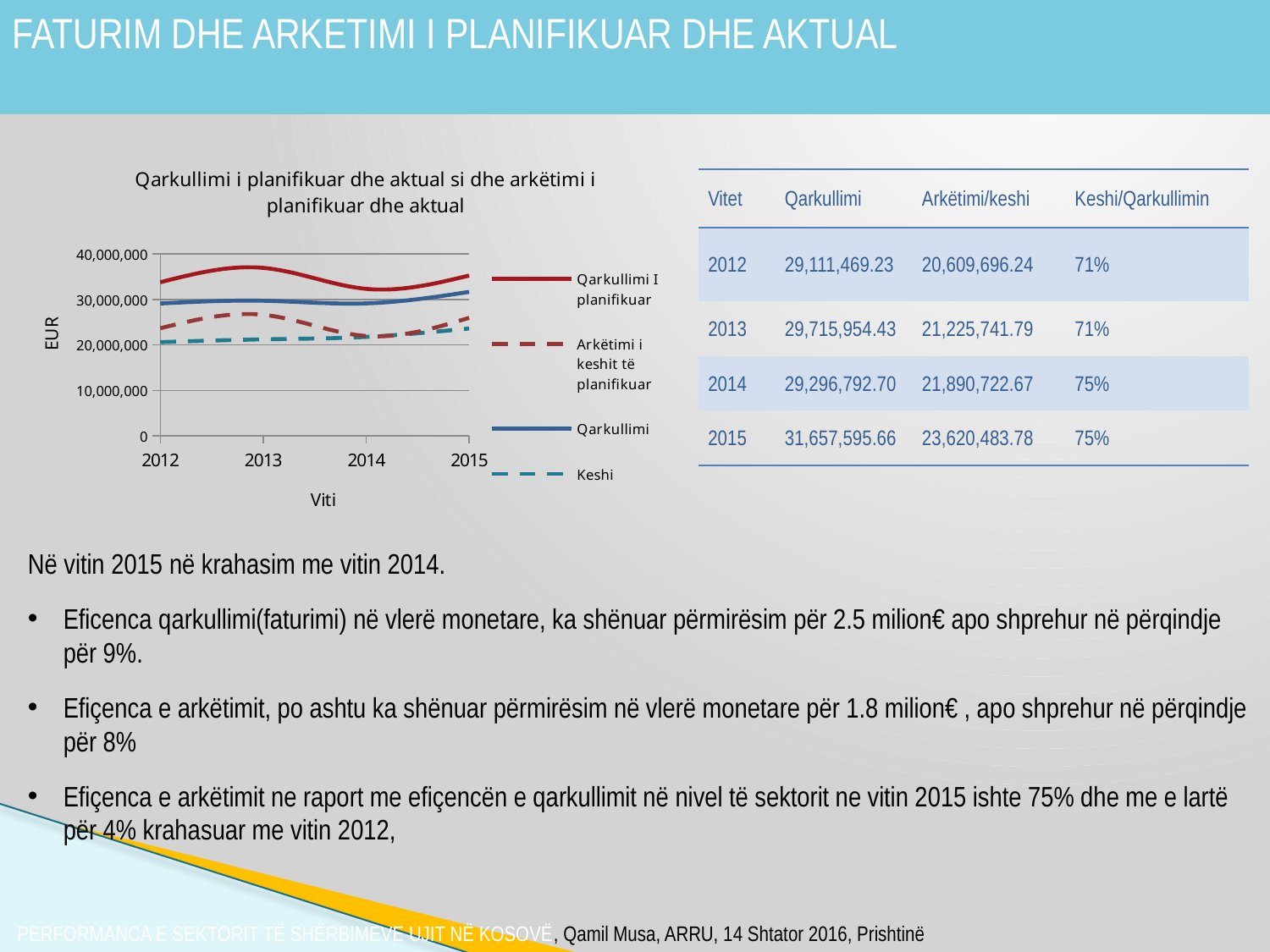
What is the label of the y axis of the chart? EUR In 2013, which is higher: Qarkullimi I planifikuar or Qarkullimi? Qarkullimi I planifikuar How many series does the chart legend list? 4 Is the value of Qarkullimi I planifikuar in 2013 greater or less than 30,000,000? greater How many years are shown on the x axis of the chart? 4 Is the value of Arkëtimi i keshit të planifikuar in 2013 greater or less than 20,000,000? greater What kind of chart is shown on the slide? line chart Does the Keshi line rise or fall from 2012 to 2015? rise What is the title of the chart? Qarkullimi i planifikuar dhe aktual si dhe arkëtimi i planifikuar dhe aktual In which year does the Qarkullimi I planifikuar line reach its highest value? 2013 According to the table next to the chart, what is the Qarkullimi value for 2015? 31,657,595.66 Is the value of Keshi in 2015 greater or less than 30,000,000? less